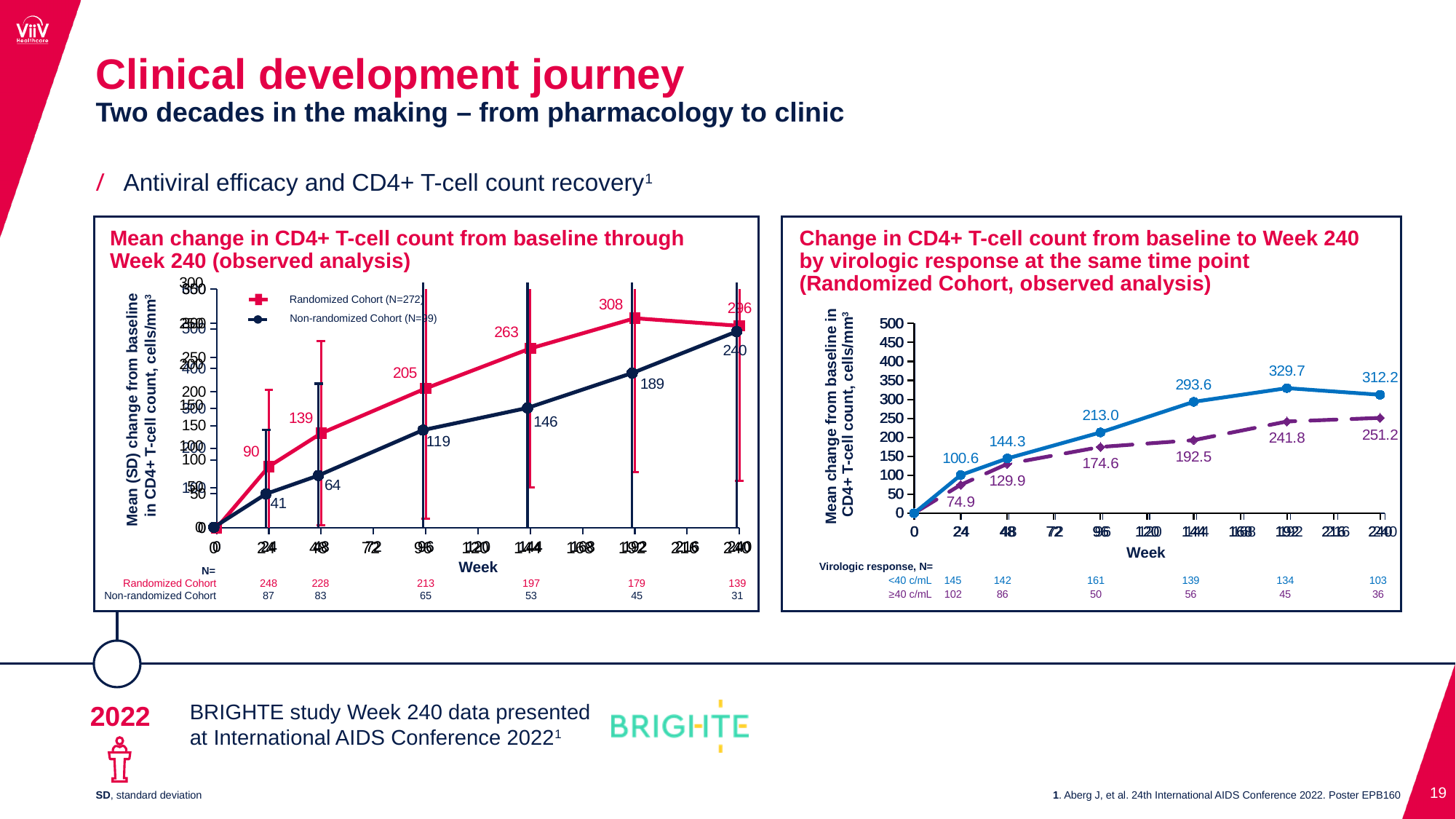
In the right chart (Change in CD4+ T-cell count by virologic response), what is the value for the ≥40 c/mL group at Week 240? 251.2 In the right chart (Change in CD4+ T-cell count by virologic response), what is the difference between the <40 c/mL and ≥40 c/mL values at Week 192? 87.9 In the left chart (Mean change in CD4+ T-cell count from baseline through Week 240), what is the N for the Randomized Cohort at Week 240? 139 In the left chart (Mean change in CD4+ T-cell count from baseline through Week 240), what is the difference between the Randomized Cohort and Non-randomized Cohort values at Week 144? 117 In the left chart (Mean change in CD4+ T-cell count from baseline through Week 240), how many series does the legend list? 2 In the left chart (Mean change in CD4+ T-cell count from baseline through Week 240), which cohort has the larger value at Week 48? Randomized Cohort In the right chart (Change in CD4+ T-cell count by virologic response), what is the lowest labelled value for the ≥40 c/mL group? 74.9 In the left chart (Mean change in CD4+ T-cell count from baseline through Week 240), what is the value for the Non-randomized Cohort at Week 96? 119 In the right chart (Change in CD4+ T-cell count by virologic response), what is the value for the <40 c/mL group at Week 144? 293.6 What kind of chart is the right chart (Change in CD4+ T-cell count by virologic response)? Line chart In the left chart (Mean change in CD4+ T-cell count from baseline through Week 240), what is the value for the Randomized Cohort at Week 192? 308 In the left chart (Mean change in CD4+ T-cell count from baseline through Week 240), at which week does the Randomized Cohort reach its highest labelled value? Week 192